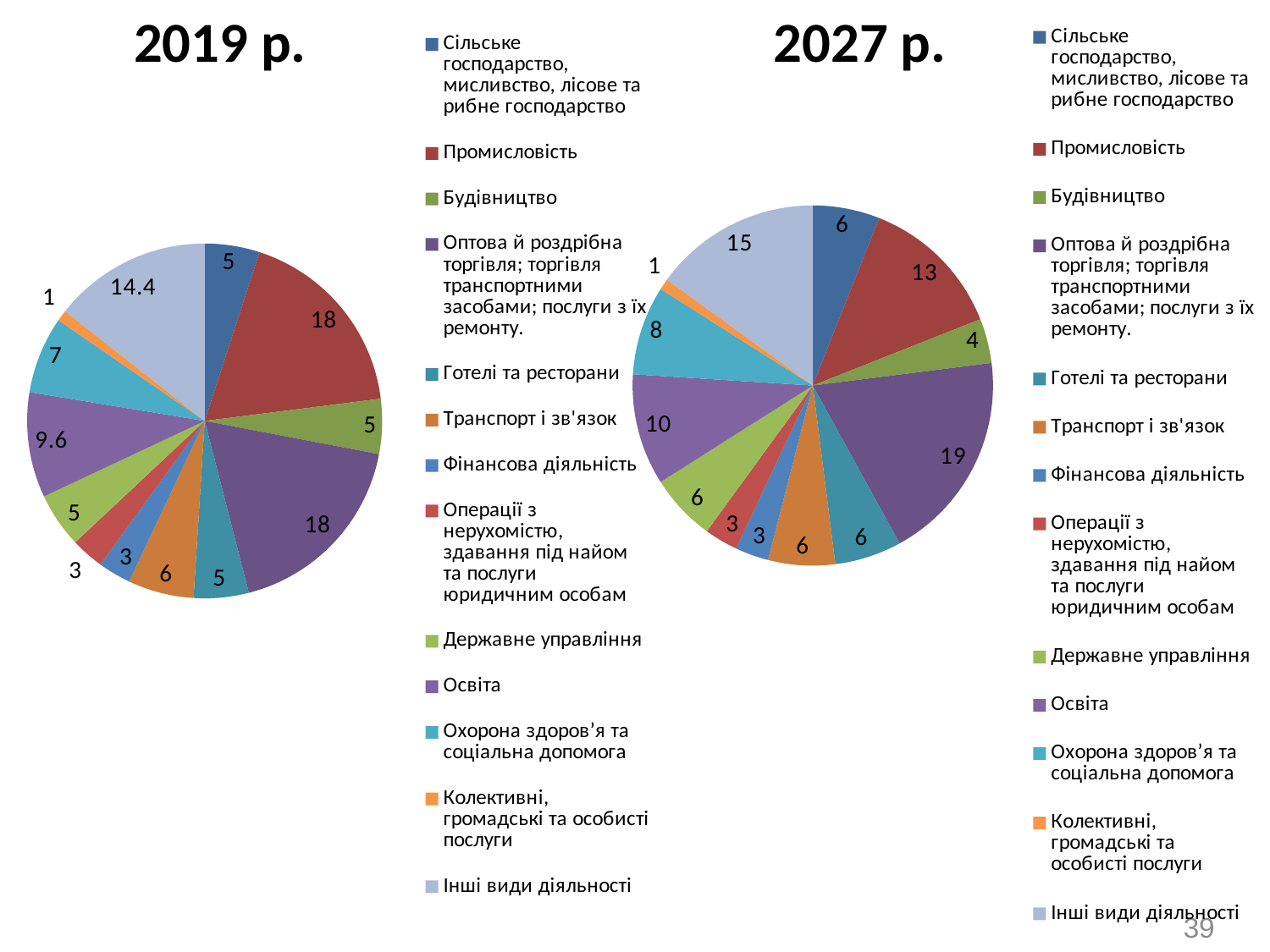
What is the difference between the value for Промисловість in the 2019 р. chart and in the 2027 р. chart? 5 What colour is the Промисловість slice in the 2019 р. chart? dark red In the 2027 р. chart, what is the value for Оптова й роздрібна торгівля; торгівля транспортними засобами; послуги з їх ремонту? 19 In the 2027 р. chart, what is the difference between Інші види діяльності and Охорона здоров'я та соціальна допомога? 7 In the 2019 р. chart, what is the value for Інші види діяльності? 14.4 What type of chart is used for the 2019 р. chart? pie chart How many categories does the legend of the 2027 р. chart list? 13 In the 2027 р. chart, which category has the largest slice? Оптова й роздрібна торгівля; торгівля транспортними засобами; послуги з їх ремонту In the 2027 р. chart, what is the value for Промисловість? 13 In the 2019 р. chart, what is the value for Освіта? 9.6 In the 2019 р. chart, which category has the smallest slice? Колективні, громадські та особисті послуги In the 2019 р. chart, which is larger: Охорона здоров'я та соціальна допомога or Транспорт і зв'язок? Охорона здоров'я та соціальна допомога